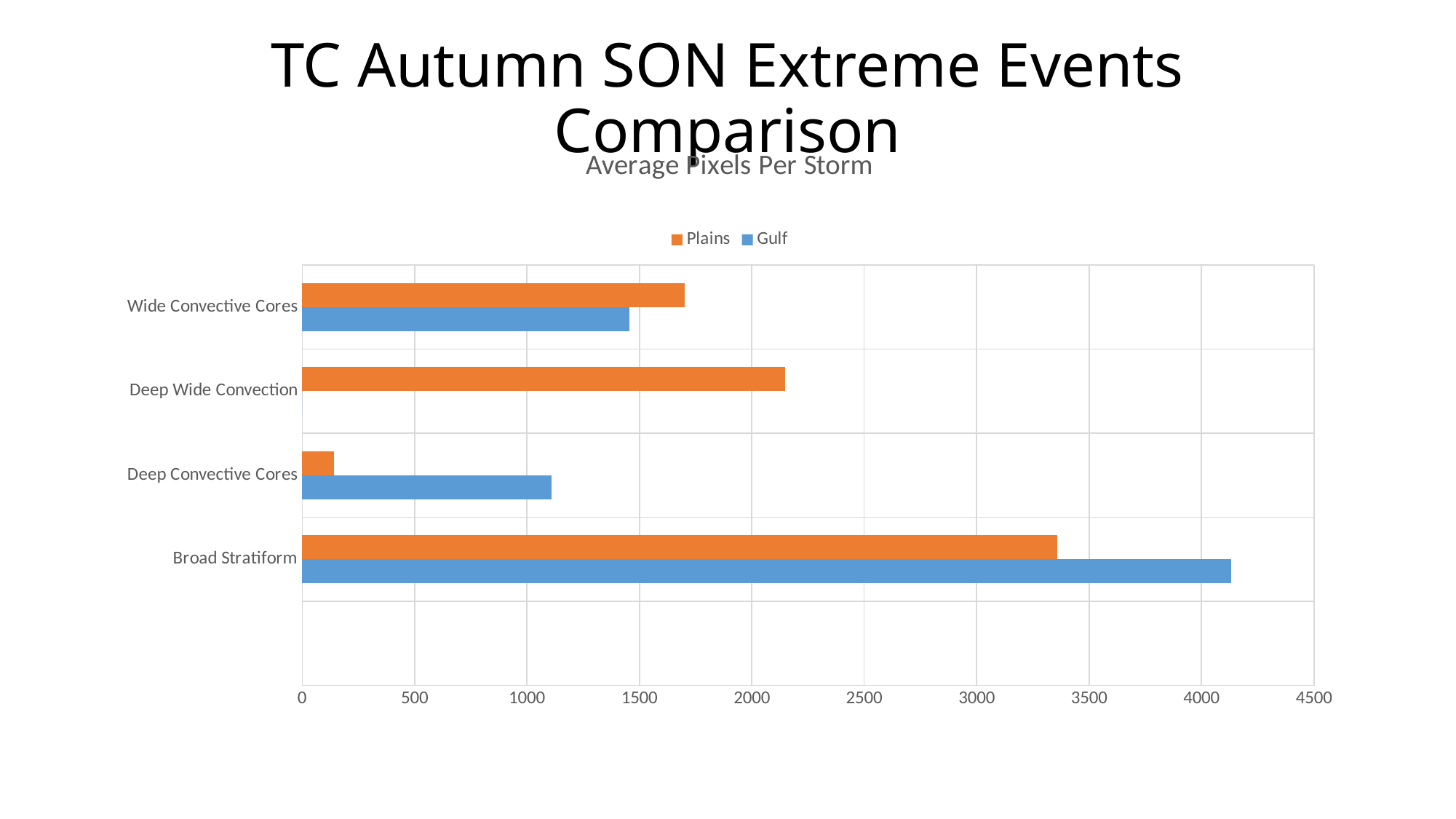
What kind of chart is shown on the slide? bar chart For Deep Convective Cores, which series has the larger value, Plains or Gulf? Gulf Is the Plains value for Deep Convective Cores greater or less than 500? less How many categories are shown on the vertical axis? 4 For Broad Stratiform, which series has the larger value, Plains or Gulf? Gulf Which category has the lowest Plains value? Deep Convective Cores How many series does the legend list? 2 What is the title of the chart? Average Pixels Per Storm Is the Plains value for Deep Wide Convection greater or less than 2000? greater Which category has the highest Gulf value? Broad Stratiform Which category has the highest Plains value? Broad Stratiform Is the Gulf value for Broad Stratiform greater or less than 4000? greater